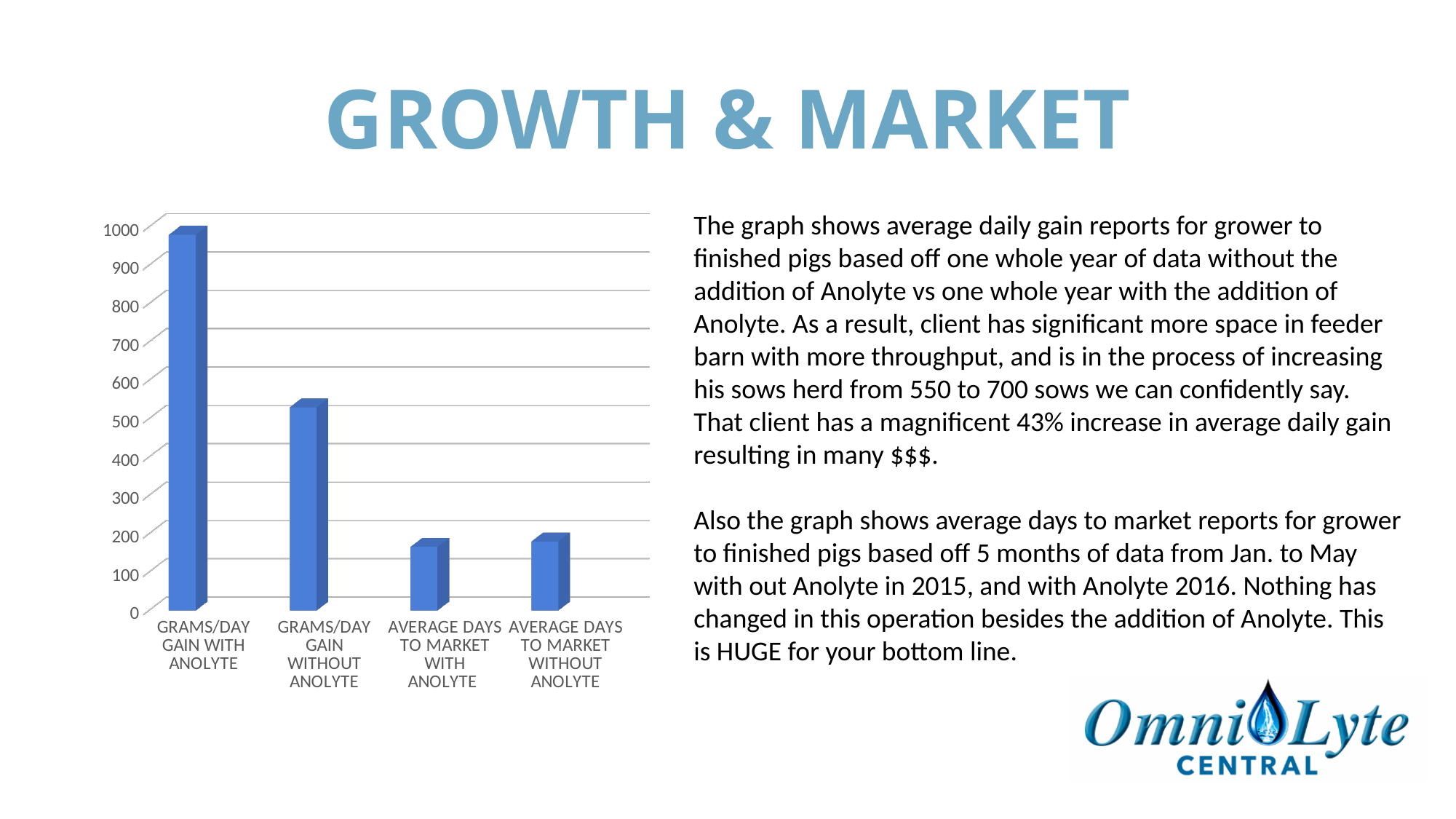
Is the value for GRAMS/DAY GAIN WITHOUT ANOLYTE greater or less than 600? less Which category has the highest bar in the chart? GRAMS/DAY GAIN WITH ANOLYTE What is the highest value shown on the chart's vertical axis? 1000 Is the value for GRAMS/DAY GAIN WITHOUT ANOLYTE greater or less than 400? greater Which is larger, GRAMS/DAY GAIN WITHOUT ANOLYTE or AVERAGE DAYS TO MARKET WITHOUT ANOLYTE? GRAMS/DAY GAIN WITHOUT ANOLYTE What is the title of the slide containing the chart? GROWTH & MARKET How many categories are plotted in the chart? 4 Which is larger, GRAMS/DAY GAIN WITH ANOLYTE or GRAMS/DAY GAIN WITHOUT ANOLYTE? GRAMS/DAY GAIN WITH ANOLYTE Is the value for AVERAGE DAYS TO MARKET WITH ANOLYTE greater or less than 100? greater What kind of chart is shown on the slide? bar chart